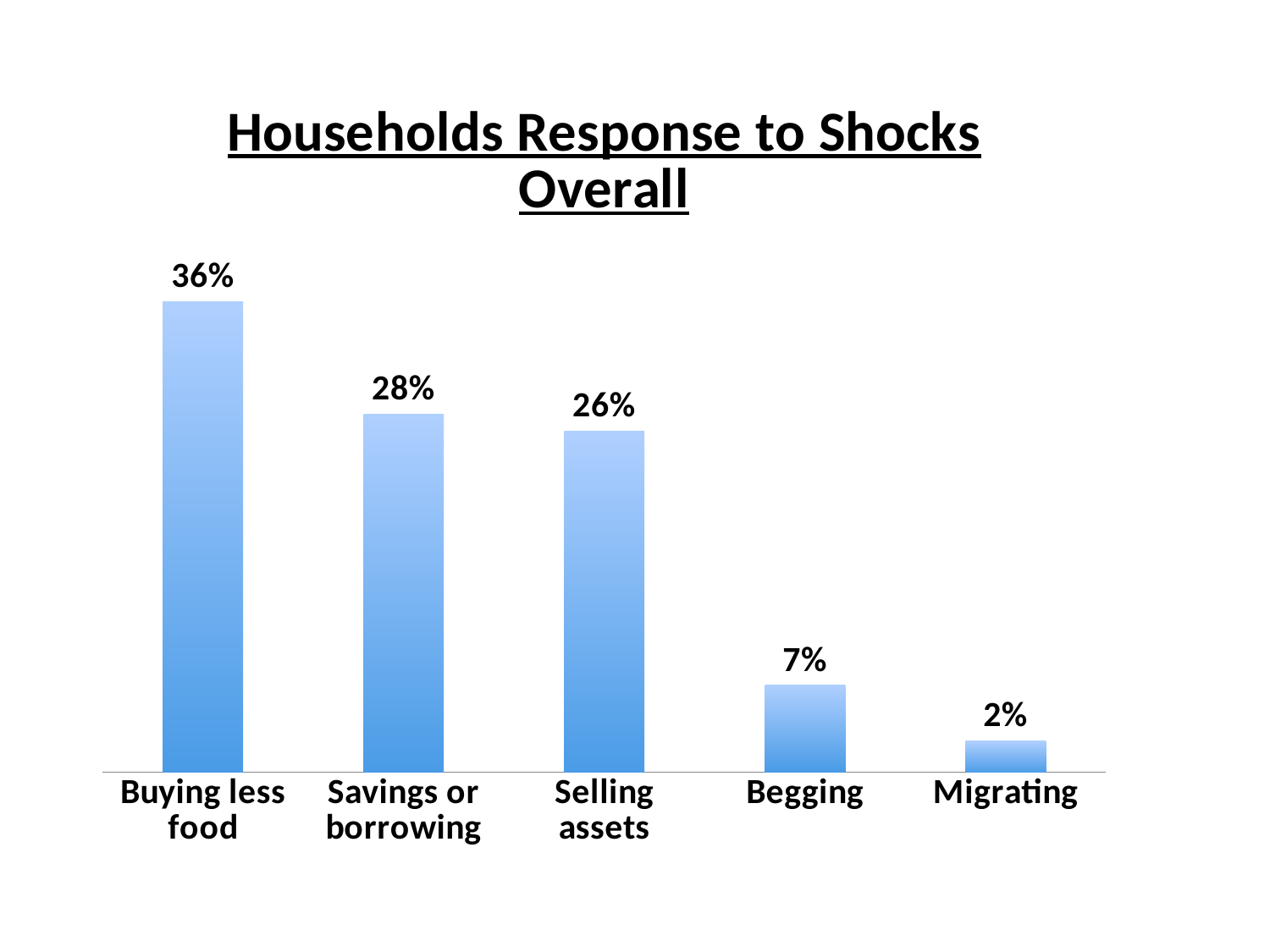
What is the value shown for Selling assets? 26% What is the value shown for Begging? 7% What is the difference between the values for Begging and Migrating? 5% Which is larger, the value for Savings or borrowing or the value for Selling assets? Savings or borrowing How many household response categories are shown in the chart? 5 What is the value shown for Savings or borrowing? 28% What is the value shown for Migrating? 2% What is the difference between the values for Buying less food and Savings or borrowing? 8% Which household response has the highest value? Buying less food What percentage of households responded to shocks by buying less food? 36% Which household response has the lowest value? Migrating What type of chart is shown on the slide? Bar chart